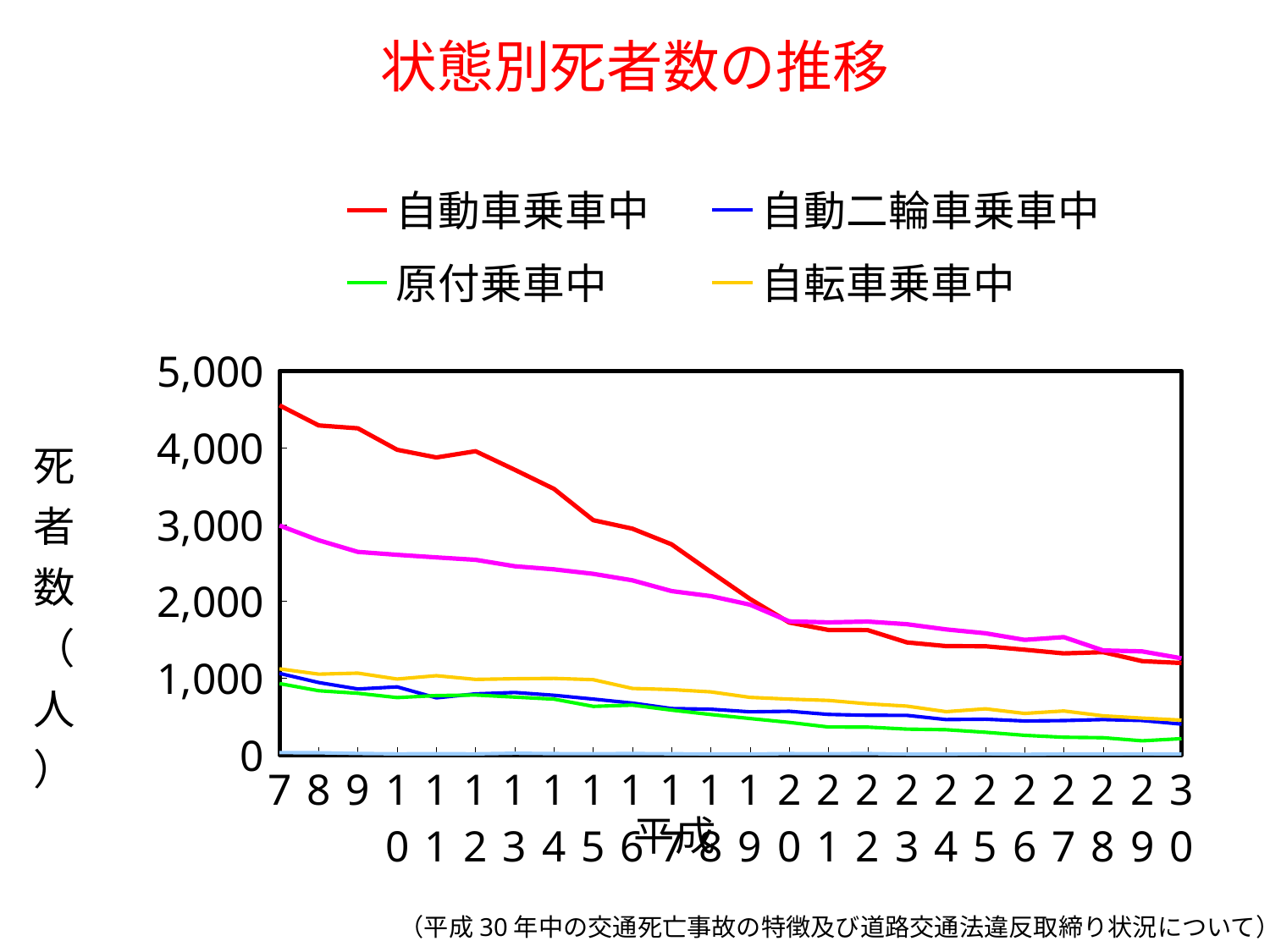
In 平成7, which is larger: 自動車乗車中 or 自転車乗車中? 自動車乗車中 Does the 自動車乗車中 line rise or fall from 平成7 to 平成30? fall Is the value for 自動車乗車中 in 平成20 greater or less than 3,000? less Is the value for 自動車乗車中 in 平成30 greater or less than 2,000? less How many years (points) are plotted along the x axis, from 平成7 to 平成30? 24 Does the 原付乗車中 line rise or fall from 平成7 to 平成30? fall Is the value for 原付乗車中 in 平成30 greater or less than 1,000? less What is the title of the chart? 状態別死者数の推移 How many series does the legend list? 4 What kind of chart is shown on the slide? line chart In 平成30, which is larger: 自転車乗車中 or 原付乗車中? 自転車乗車中